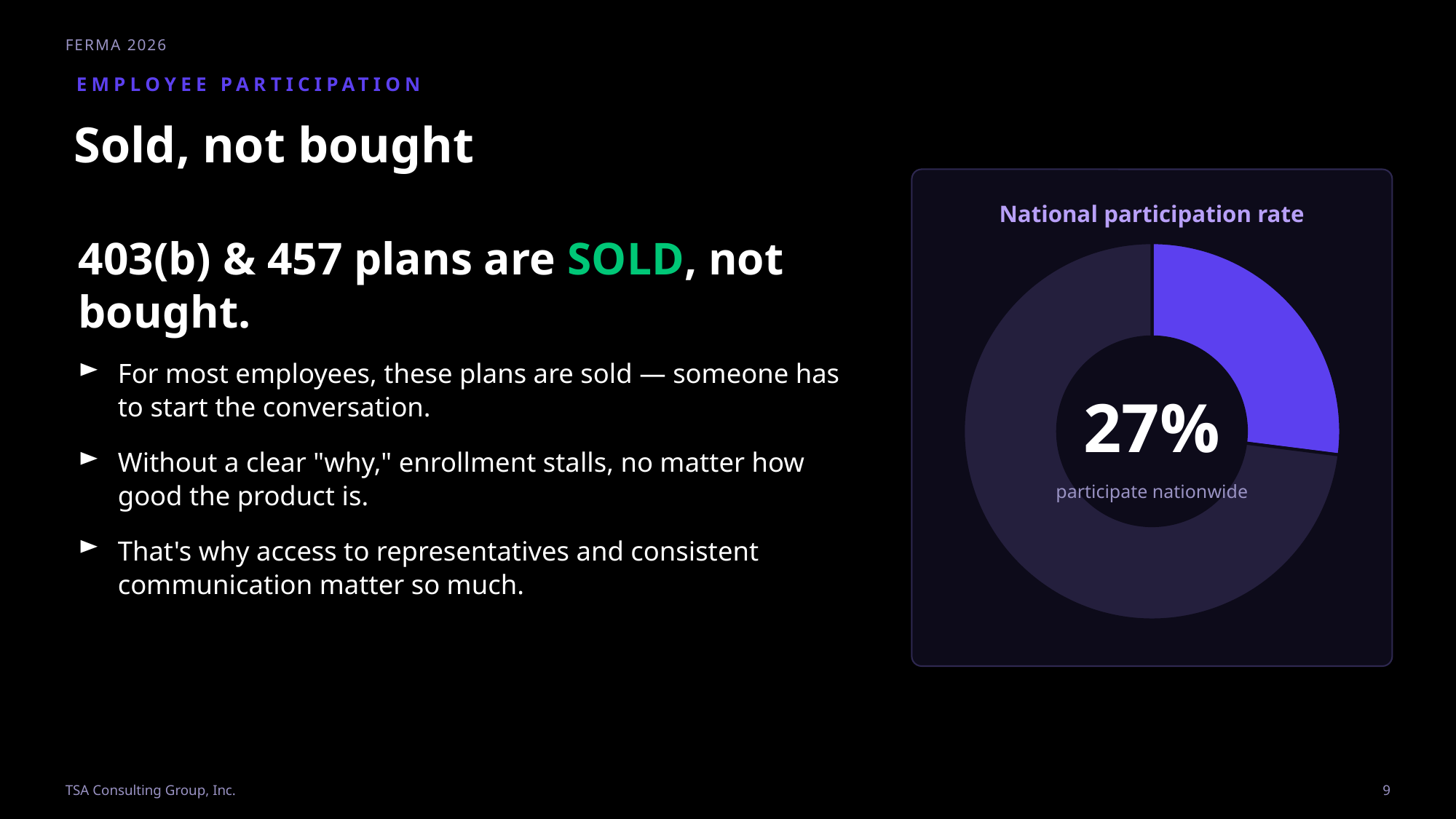
What kind of chart is shown on the slide? donut (pie) chart What is the title of the chart on the slide? National participation rate Which portion of the donut is larger: the participating slice or the remaining slice? the remaining (non-participating) slice Is the highlighted participation slice greater or less than 50% of the donut? less What share of employees participate nationwide according to the chart? 27% What share of the donut is not covered by the 27% participation slice? 73% What colour is the slice representing the national participation rate? purple How many segments does the donut chart have? 2 What value is printed in the centre of the donut chart? 27% What label appears beneath the 27% figure in the chart? participate nationwide